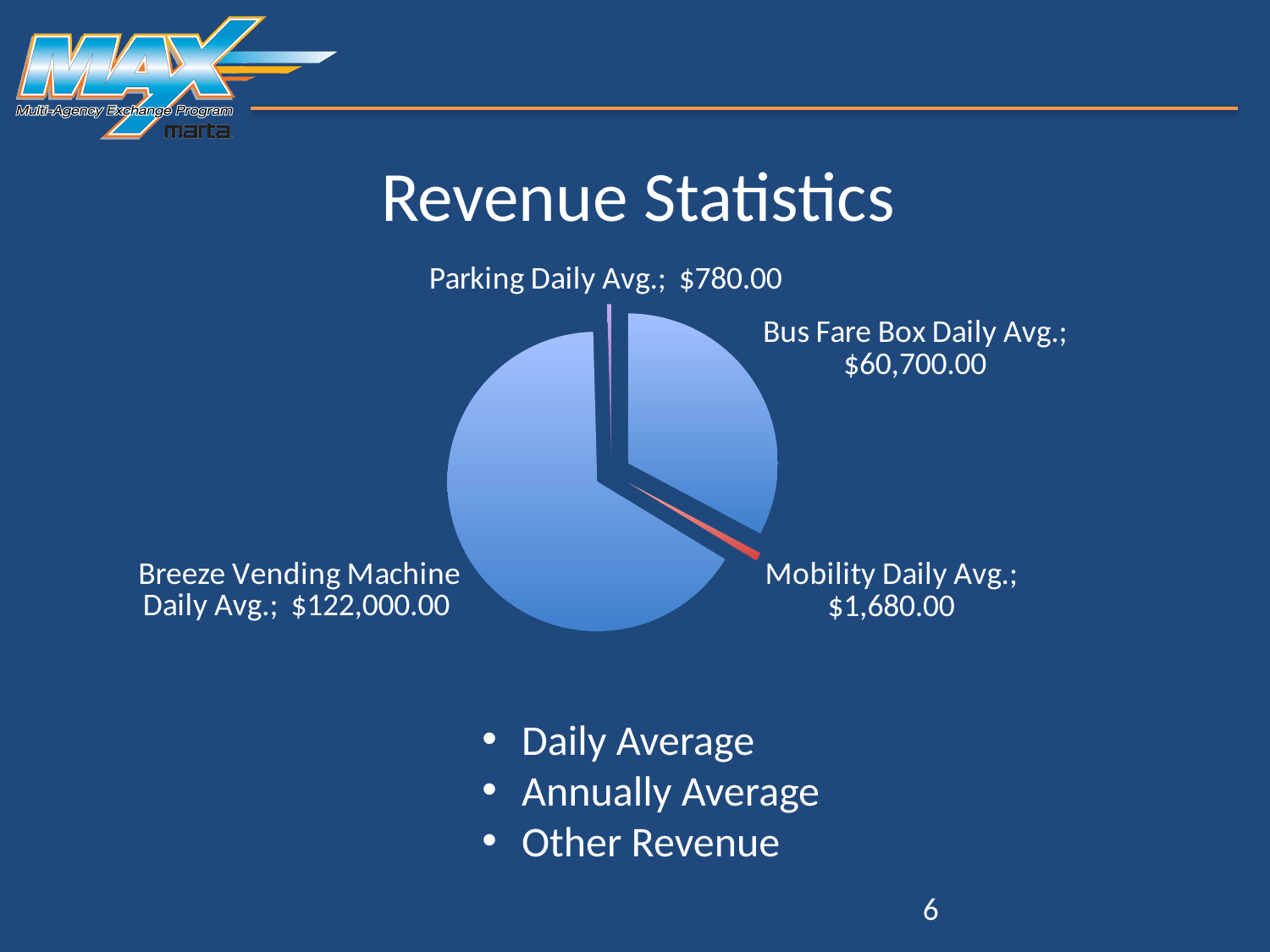
What kind of chart is shown on the slide? Pie chart What is the difference between the Mobility Daily Avg. and the Parking Daily Avg.? $900.00 How many slices does the pie chart have? 4 What is the title of the slide containing the chart? Revenue Statistics What is the value shown for Breeze Vending Machine Daily Avg. in the pie chart? $122,000.00 Which category has the largest slice in the pie chart? Breeze Vending Machine Daily Avg. What is the value shown for Parking Daily Avg. in the pie chart? $780.00 Which is larger, the Mobility Daily Avg. or the Parking Daily Avg.? Mobility Daily Avg. What is the value shown for Mobility Daily Avg. in the pie chart? $1,680.00 What is the difference between the Breeze Vending Machine Daily Avg. and the Bus Fare Box Daily Avg.? $61,300.00 What is the value shown for Bus Fare Box Daily Avg. in the pie chart? $60,700.00 Which category has the smallest slice in the pie chart? Parking Daily Avg.